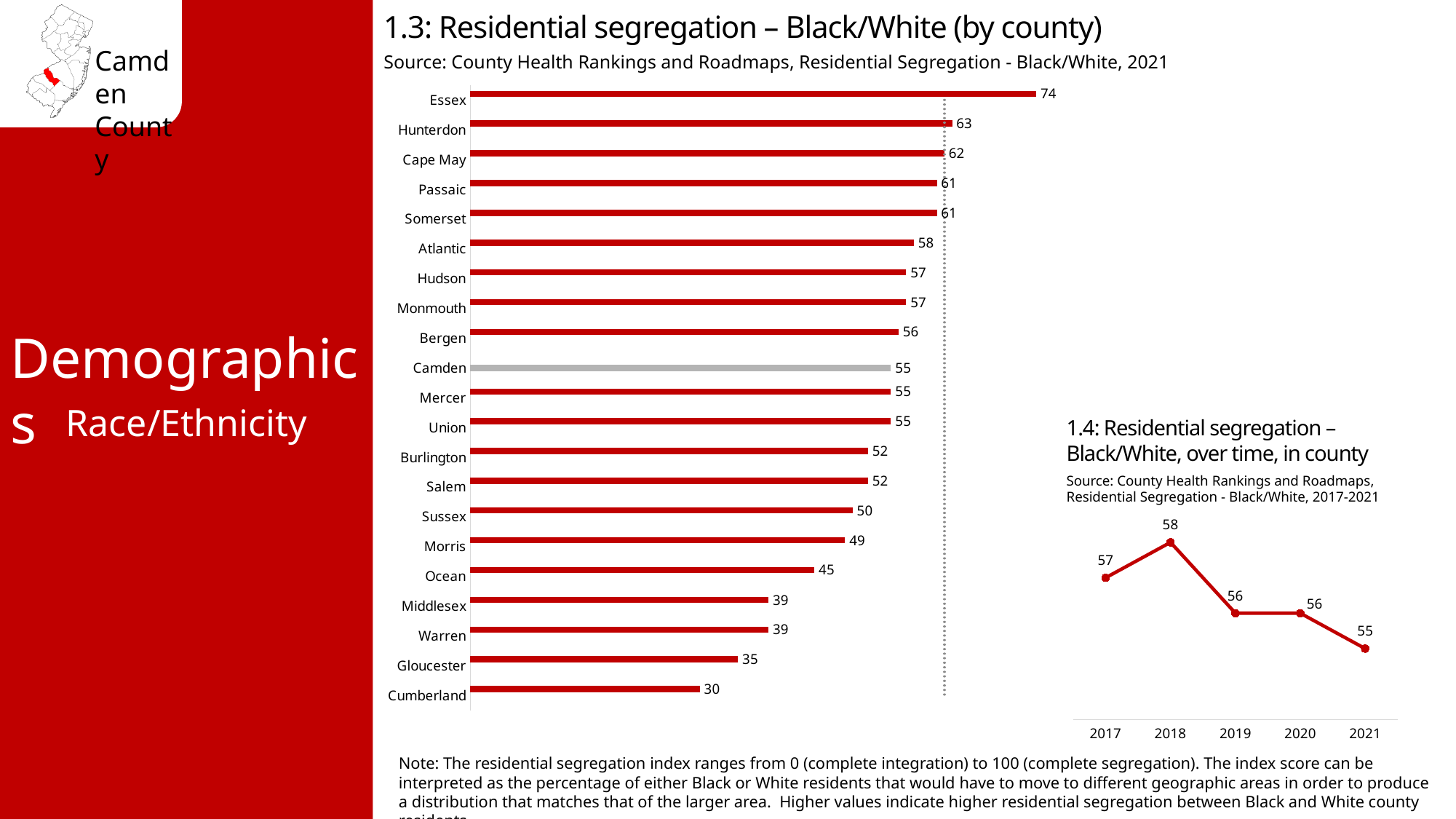
In the chart '1.3: Residential segregation – Black/White (by county)', how many counties are shown? 21 In the chart '1.3: Residential segregation – Black/White (by county)', which has a larger value, Hunterdon or Ocean? Hunterdon In the chart '1.3: Residential segregation – Black/White (by county)', what is the value for Camden? 55 In the chart '1.3: Residential segregation – Black/White (by county)', which county has the lowest value? Cumberland In the chart '1.4: Residential segregation – Black/White, over time, in county', what is the value for 2018? 58 In the chart '1.3: Residential segregation – Black/White (by county)', what is the value for Gloucester? 35 In the chart '1.3: Residential segregation – Black/White (by county)', what is the difference between the values for Essex and Cumberland? 44 In the chart '1.3: Residential segregation – Black/White (by county)', which county has the highest value? Essex What kind of chart is '1.3: Residential segregation – Black/White (by county)'? Bar chart In the chart '1.4: Residential segregation – Black/White, over time, in county', how many years are plotted? 5 In the chart '1.4: Residential segregation – Black/White, over time, in county', which year has the lowest value? 2021 In the chart '1.4: Residential segregation – Black/White, over time, in county', do the values rise or fall from 2018 to 2021? Fall